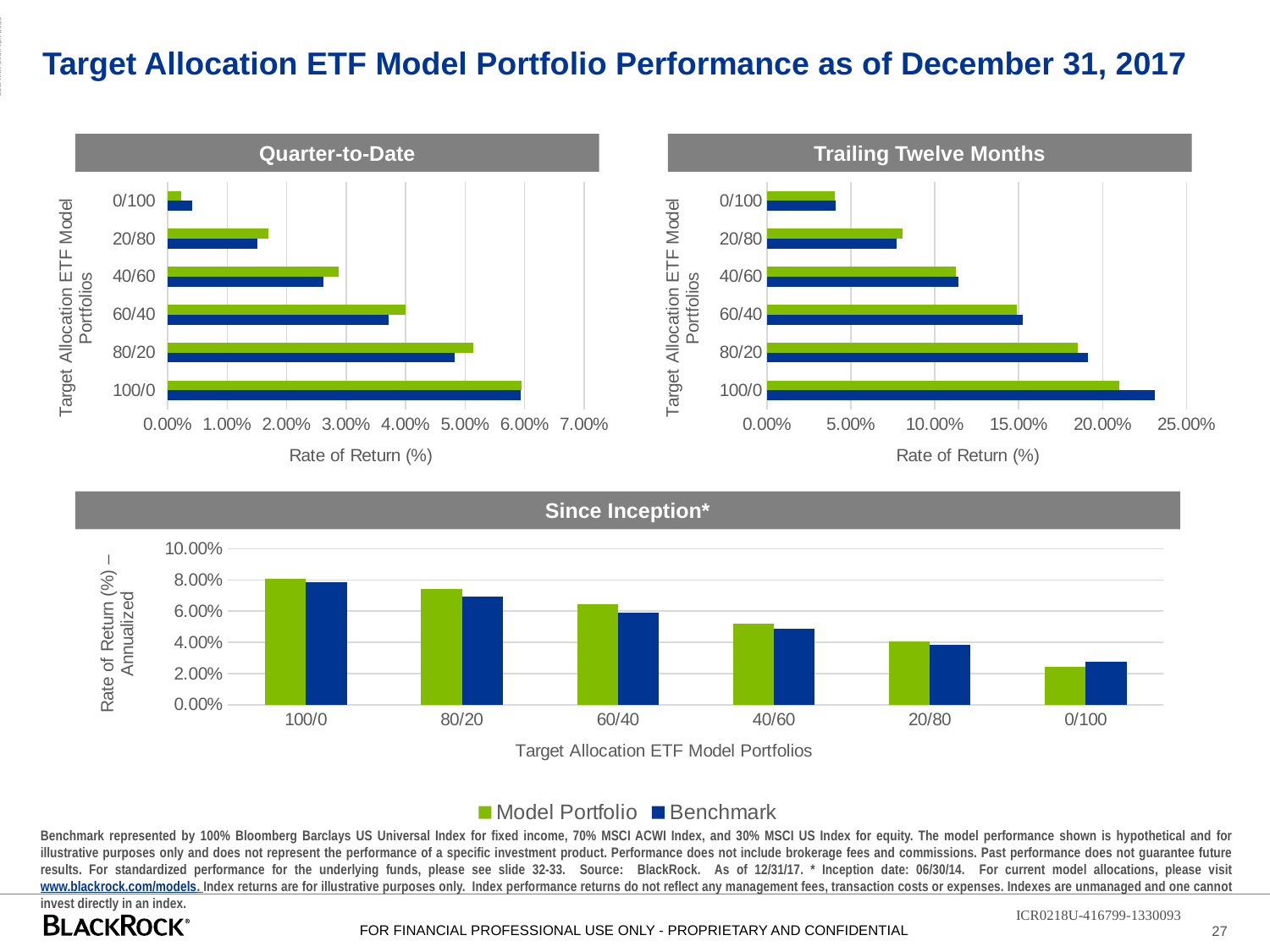
In the Trailing Twelve Months chart, which is larger for the 100/0 portfolio, the Model Portfolio or the Benchmark? Benchmark In the Since Inception* chart, is the Benchmark value for 80/20 greater or less than 8.00%? less In the Quarter-to-Date chart, is the Model Portfolio value for 60/40 greater or less than 3.00%? greater In the Since Inception* chart, do the Model Portfolio values rise or fall moving from 100/0 to 0/100 along the x axis? fall How many portfolio categories are shown in the Since Inception* chart? 6 In the Quarter-to-Date chart, which portfolio has the highest Model Portfolio rate of return? 100/0 In the Trailing Twelve Months chart, is the Model Portfolio value for 0/100 greater or less than 5.00%? less In the Quarter-to-Date chart, which portfolio has the lowest Benchmark rate of return? 0/100 What kind of chart is the Since Inception* chart? bar chart Which colour represents the Benchmark series in the charts? blue How many series does the legend list? 2